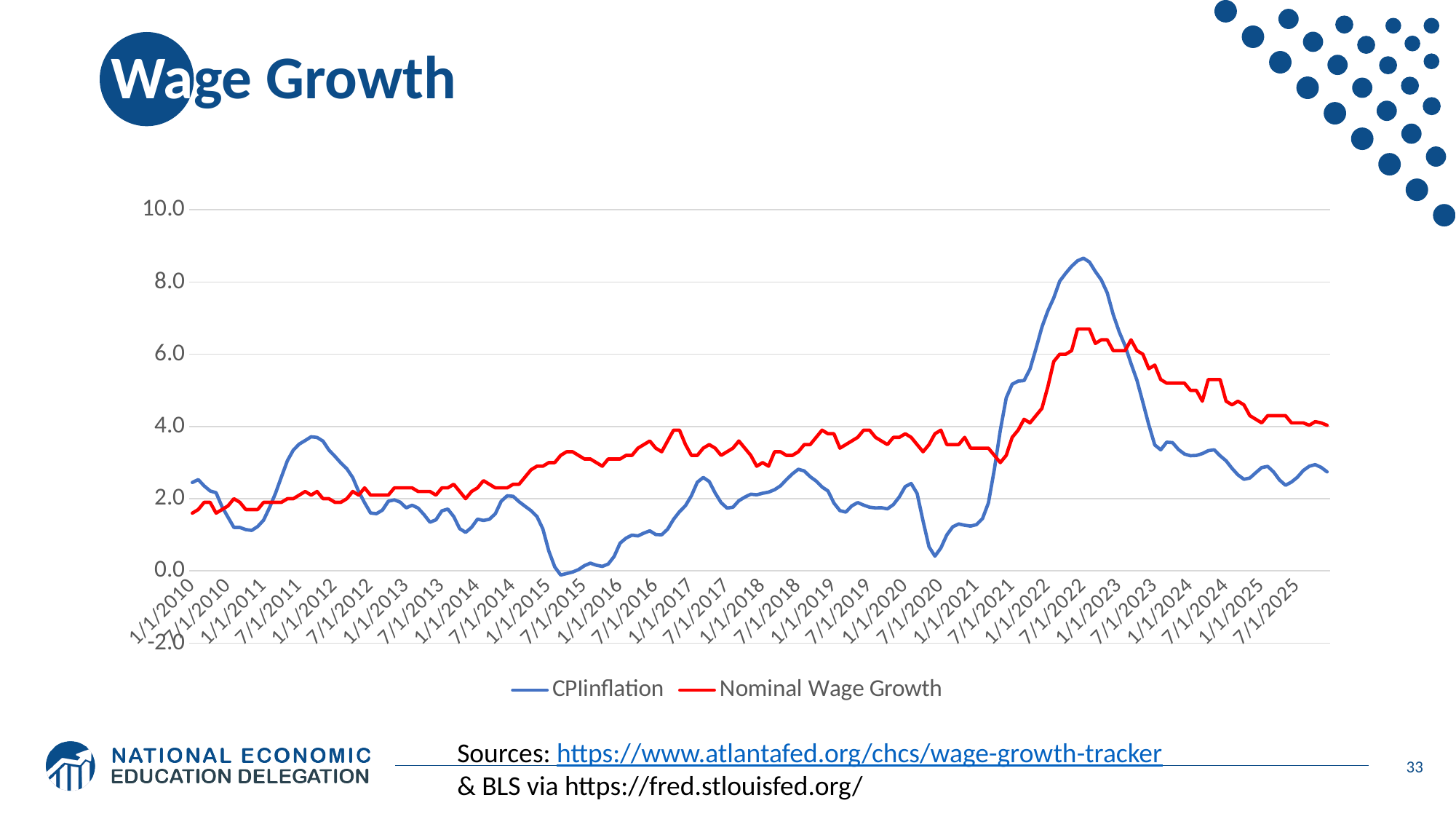
What are the two series named in the legend? CPIinflation and Nominal Wage Growth Is the value of Nominal Wage Growth at 1/1/2024 greater or less than 4.0? greater Which series is higher at 1/1/2017, CPI inflation or Nominal Wage Growth? Nominal Wage Growth Which colour is used for the Nominal Wage Growth line? red Is the peak value of Nominal Wage Growth in 2022 greater or less than 6.0? greater Which series is higher at 7/1/2022, CPI inflation or Nominal Wage Growth? CPIinflation Which series reaches the highest value anywhere on the chart? CPIinflation Is the value of Nominal Wage Growth at 1/1/2010 greater or less than 2.0? less What kind of chart is shown on the slide? line chart Does CPI inflation rise or fall between 7/1/2022 and 7/1/2023? fall How many series does the legend list? 2